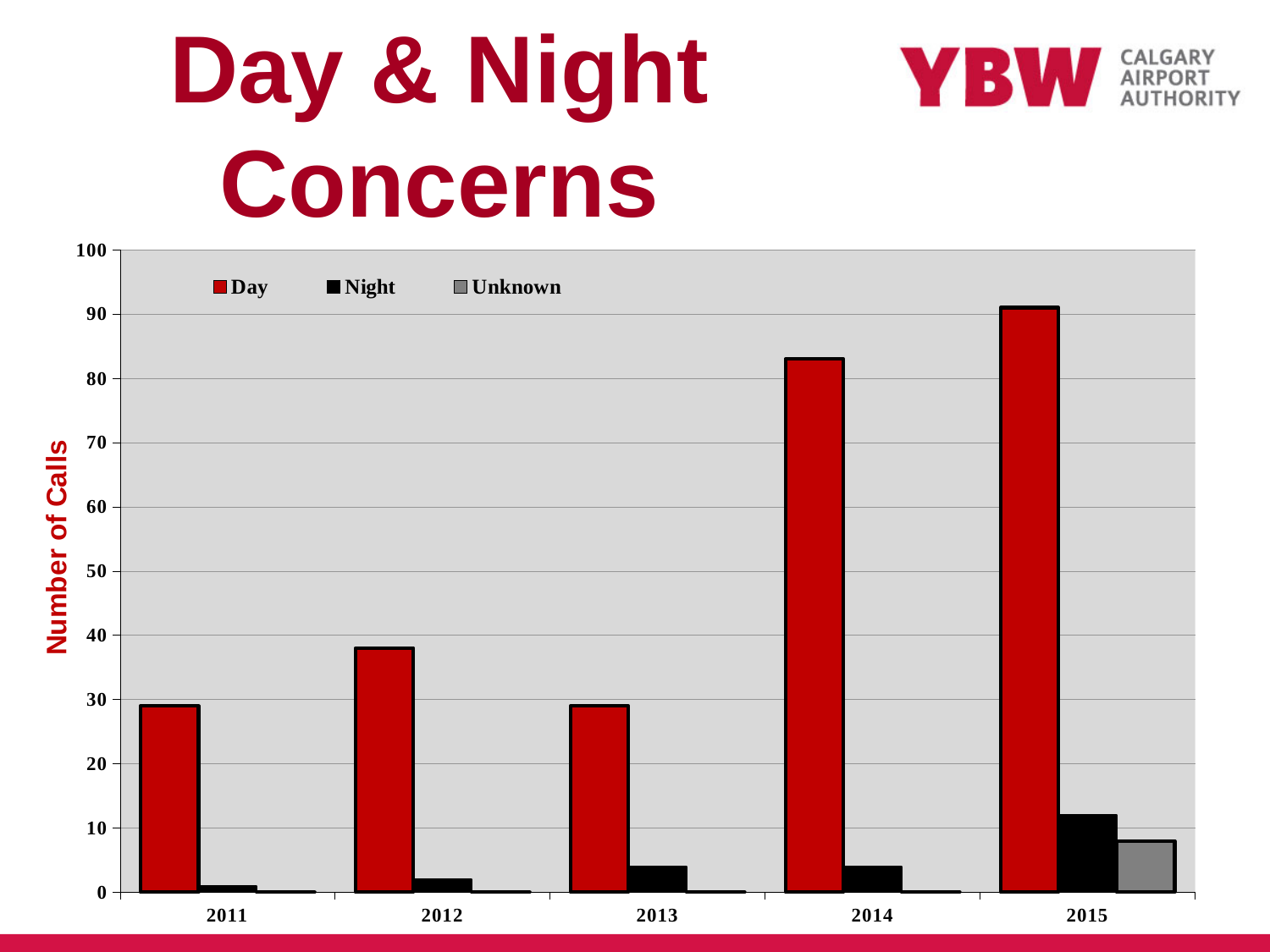
How many series does the legend list? 3 How many years are shown on the x axis? 5 Is the Day value for 2014 greater or less than 80? greater In which year is the Night value highest? 2015 Do the Day values rise or fall from 2013 to 2015? rise Which is larger, the Day value for 2014 or the Day value for 2012? 2014 In which year is the Day value highest? 2015 What kind of chart is shown on the slide? bar chart What is the label on the y axis? Number of Calls Is the Day value for 2012 greater or less than 40? less Is the Unknown value for 2015 greater or less than 10? less